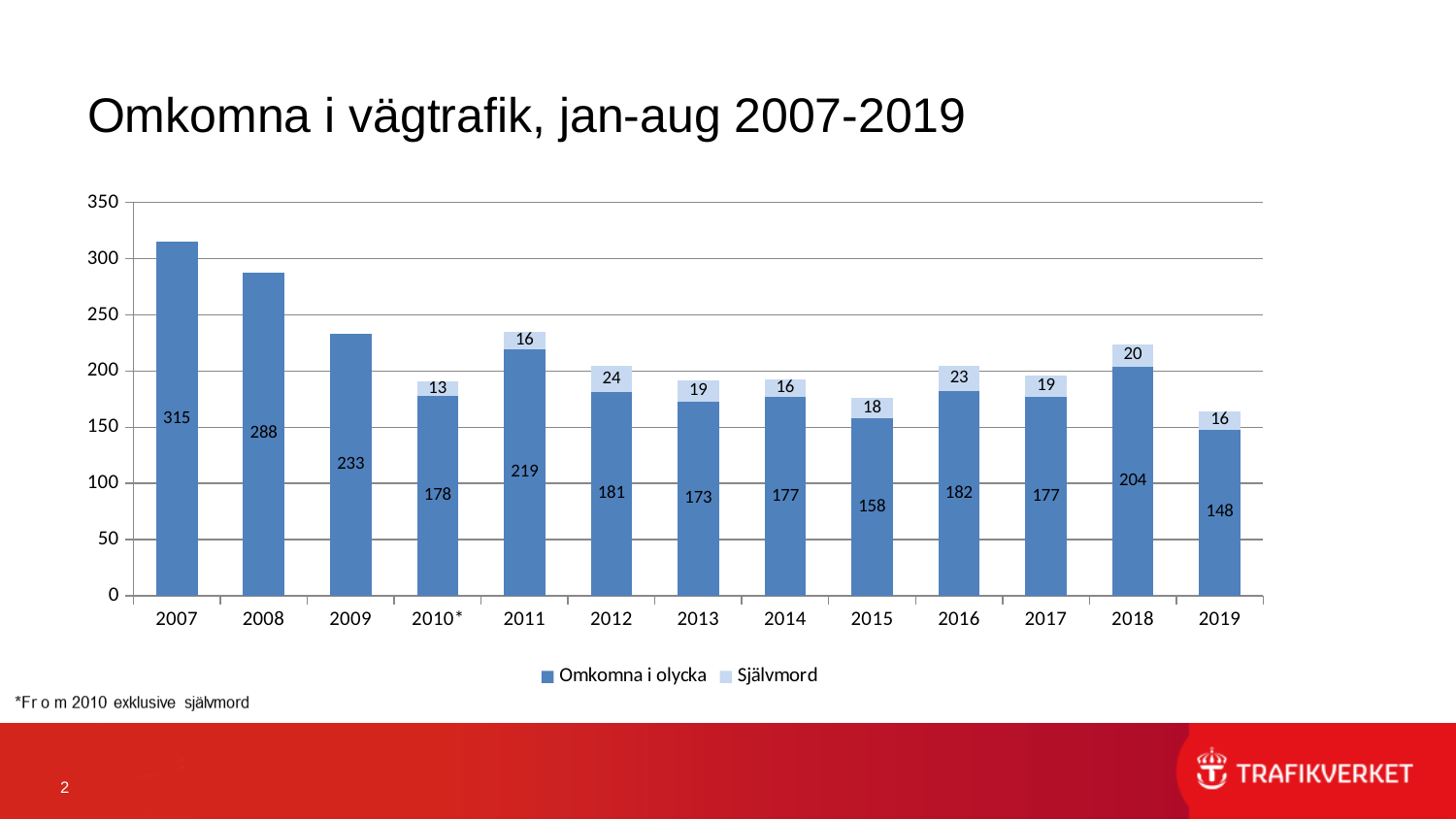
What is the value of 'Självmord' for 2012? 24 What is the value of 'Omkomna i olycka' for 2019? 148 What type of chart is shown on the slide? Stacked bar chart What is the title of the chart? Omkomna i vägtrafik, jan-aug 2007-2019 What is the difference between the 'Omkomna i olycka' values for 2018 and 2019? 56 How many series does the legend list? 2 What is the total of the stacked bar for 2011? 235 Which year has the lowest value for 'Omkomna i olycka'? 2019 Which is larger, the 'Omkomna i olycka' value for 2016 or for 2015? 2016 Which year has the highest value for 'Omkomna i olycka'? 2007 How many years are shown on the x axis? 13 What is the value of 'Omkomna i olycka' for 2007? 315